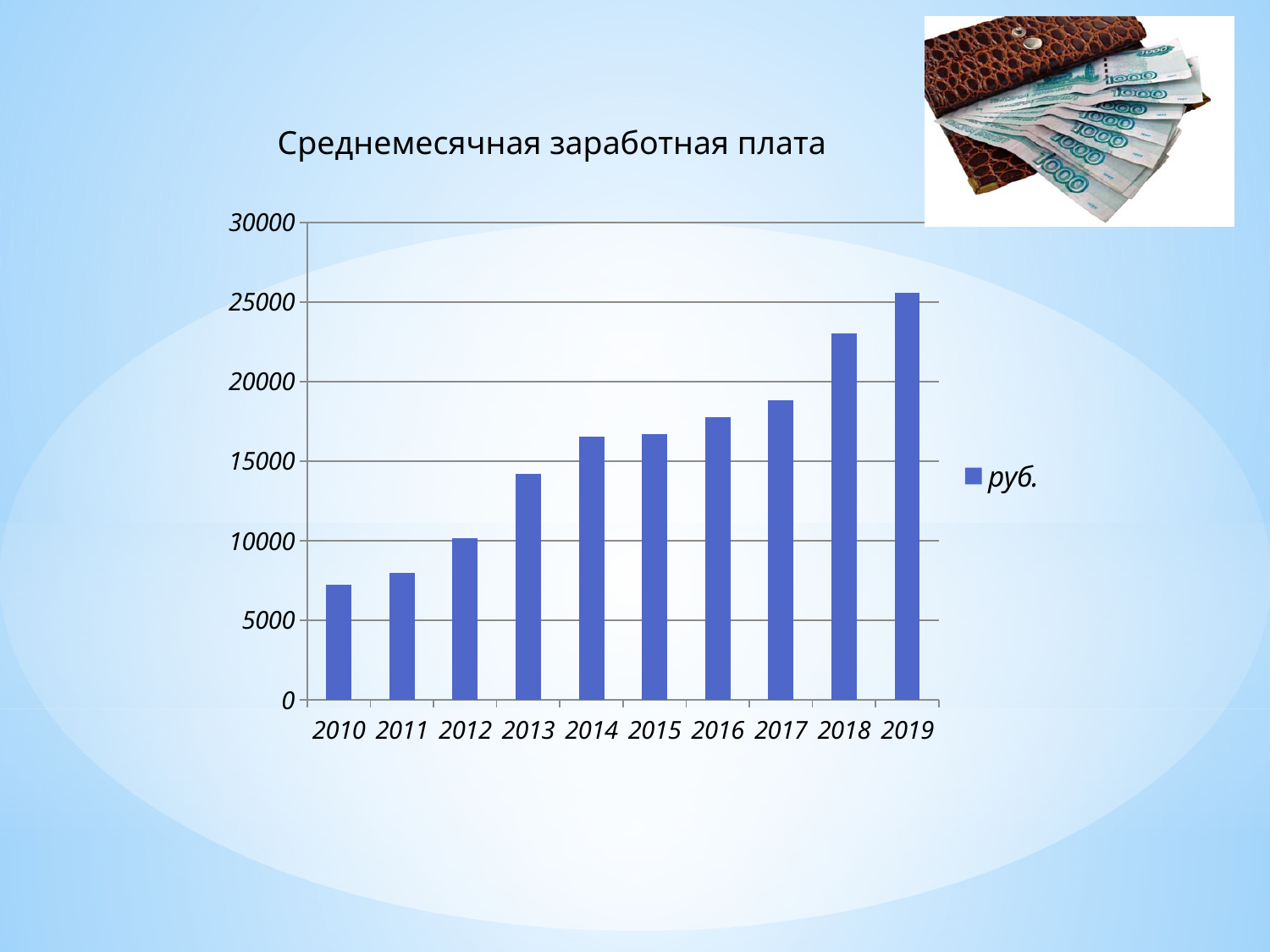
Is the value for 2010 greater or less than 10000? less Which year has the highest value? 2019 Do the values rise or fall from 2010 to 2019? rise Which is larger, the value for 2017 or the value for 2018? 2018 Is the value for 2013 greater or less than 15000? less What type of chart is shown on the slide? bar chart How many series does the legend list? 1 What is the title of the chart? Среднемесячная заработная плата What is the legend entry for the series? руб. How many years are shown on the x axis? 10 Which year has the lowest value? 2010 Is the value for 2018 greater or less than 20000? greater